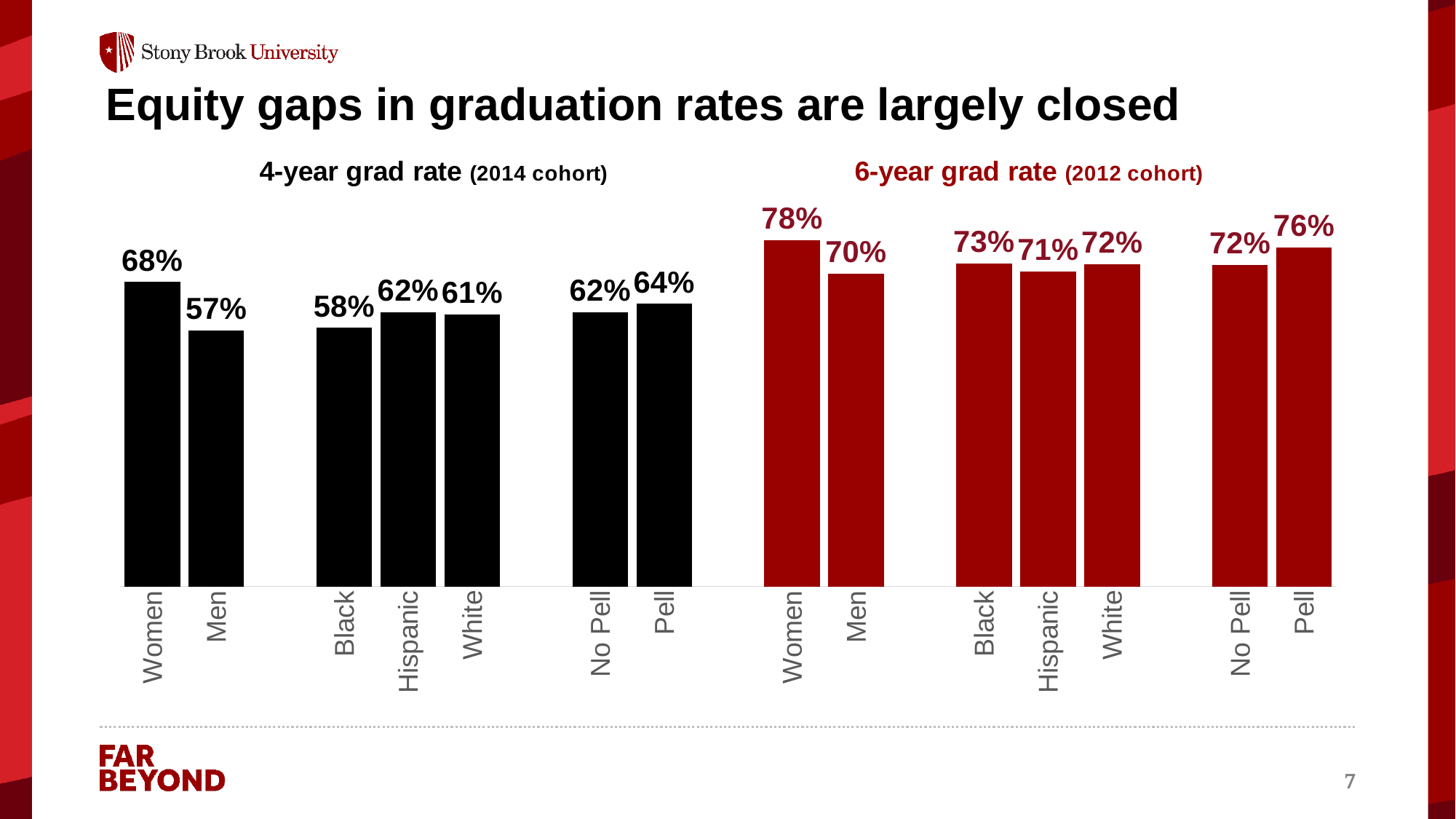
What colour are the bars in the 6-year grad rate (2012 cohort) chart? Red In the 4-year grad rate (2014 cohort) chart, what is the value for White? 61% In the 4-year grad rate (2014 cohort) chart, which is larger, the value for Hispanic or the value for Black? Hispanic In the 6-year grad rate (2012 cohort) chart, what is the difference between the values for Pell and No Pell? 4% In the 6-year grad rate (2012 cohort) chart, which is larger, the value for Women or the value for Men? Women In the 4-year grad rate (2014 cohort) chart, what is the value for Women? 68% In the 6-year grad rate (2012 cohort) chart, what is the value for Pell? 76% In the 4-year grad rate (2014 cohort) chart, which category has the lowest value? Men How many categories are shown in the 4-year grad rate (2014 cohort) chart? 7 In the 4-year grad rate (2014 cohort) chart, what is the difference between the values for Women and Men? 11% In the 6-year grad rate (2012 cohort) chart, which category has the highest value? Women What kind of chart is used for the 6-year grad rate (2012 cohort)? Bar chart